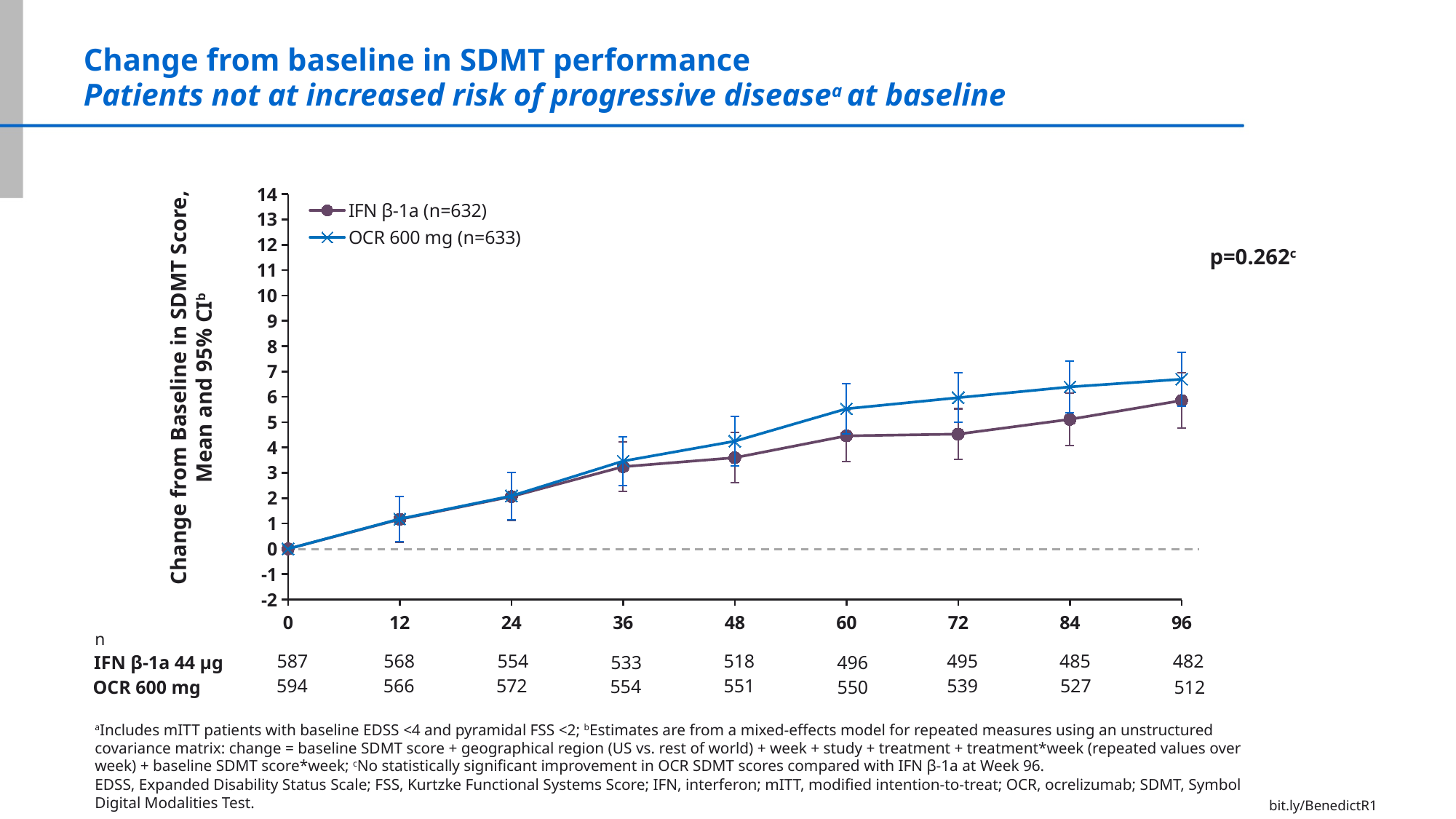
How many time points are plotted along the x axis? 9 What p-value is shown on the chart? p=0.262 Is the value for IFN β-1a at week 60 greater or less than 5? less At week 96, which series has the higher change from baseline in SDMT score, IFN β-1a or OCR 600 mg? OCR 600 mg How many series does the legend list? 2 Is the value for OCR 600 mg at week 96 greater or less than 6? greater What kind of chart is shown on the slide? line chart Is the value for IFN β-1a at week 48 greater or less than 4? less What is the n for IFN β-1a 44 µg at week 0 in the table below the chart? 587 Do the values for OCR 600 mg rise or fall from week 0 to week 96? rise What is the n for OCR 600 mg at week 96 in the table below the chart? 512